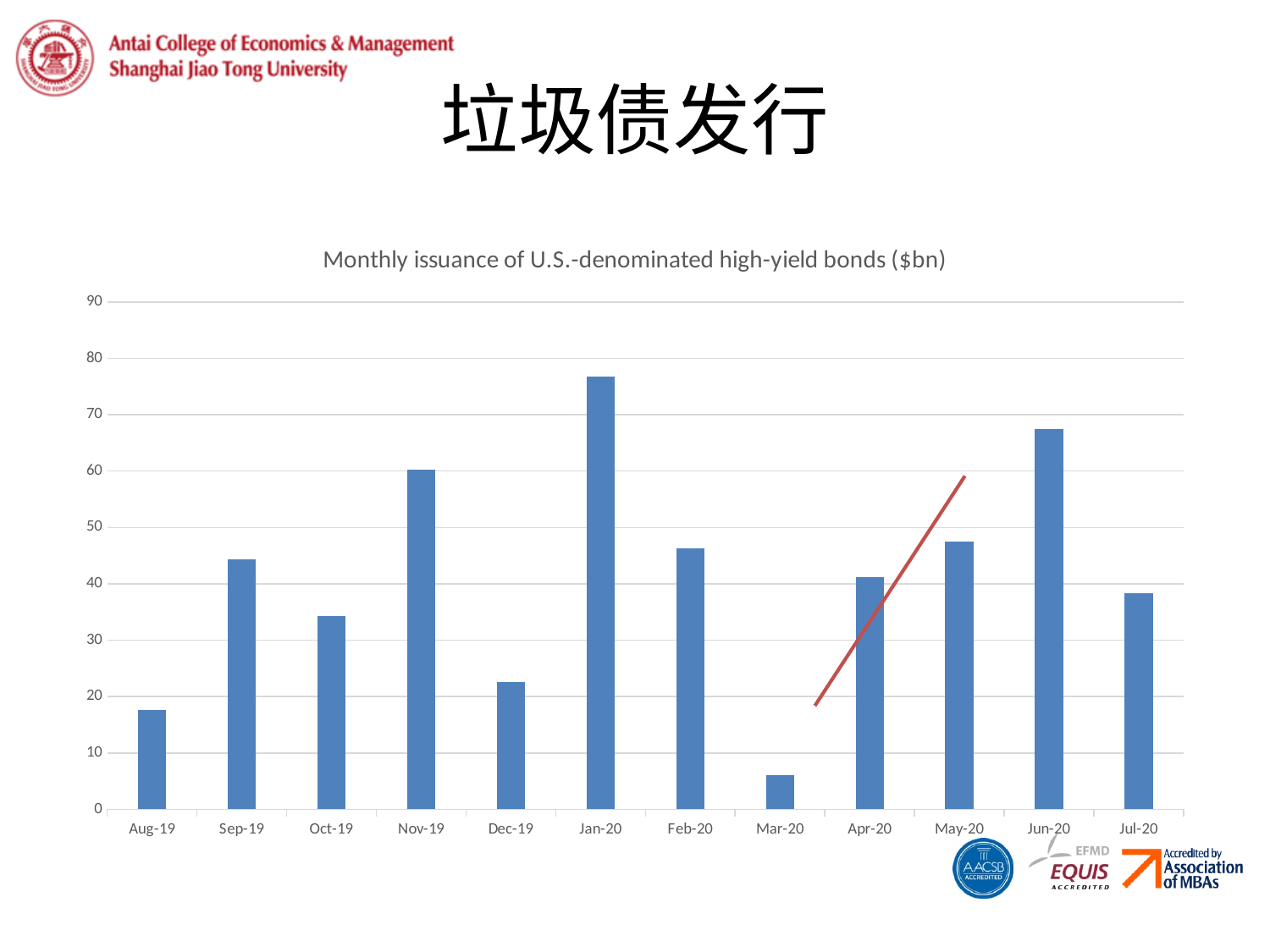
Which is larger, the value for Sep-19 or the value for Oct-19? Sep-19 What colour is the diagonal line drawn over the bars between Mar-20 and May-20? red What kind of chart is shown on the slide? bar chart How many months are plotted on the x axis? 12 Which month has the highest issuance? Jan-20 Is the value for Aug-19 greater or less than 20? less What is the title of the chart? Monthly issuance of U.S.-denominated high-yield bonds ($bn) Is the value for Jun-20 greater or less than 60? greater Do the values rise or fall from Mar-20 to Jun-20? rise Is the value for Jan-20 greater or less than 70? greater Which month has the lowest issuance? Mar-20